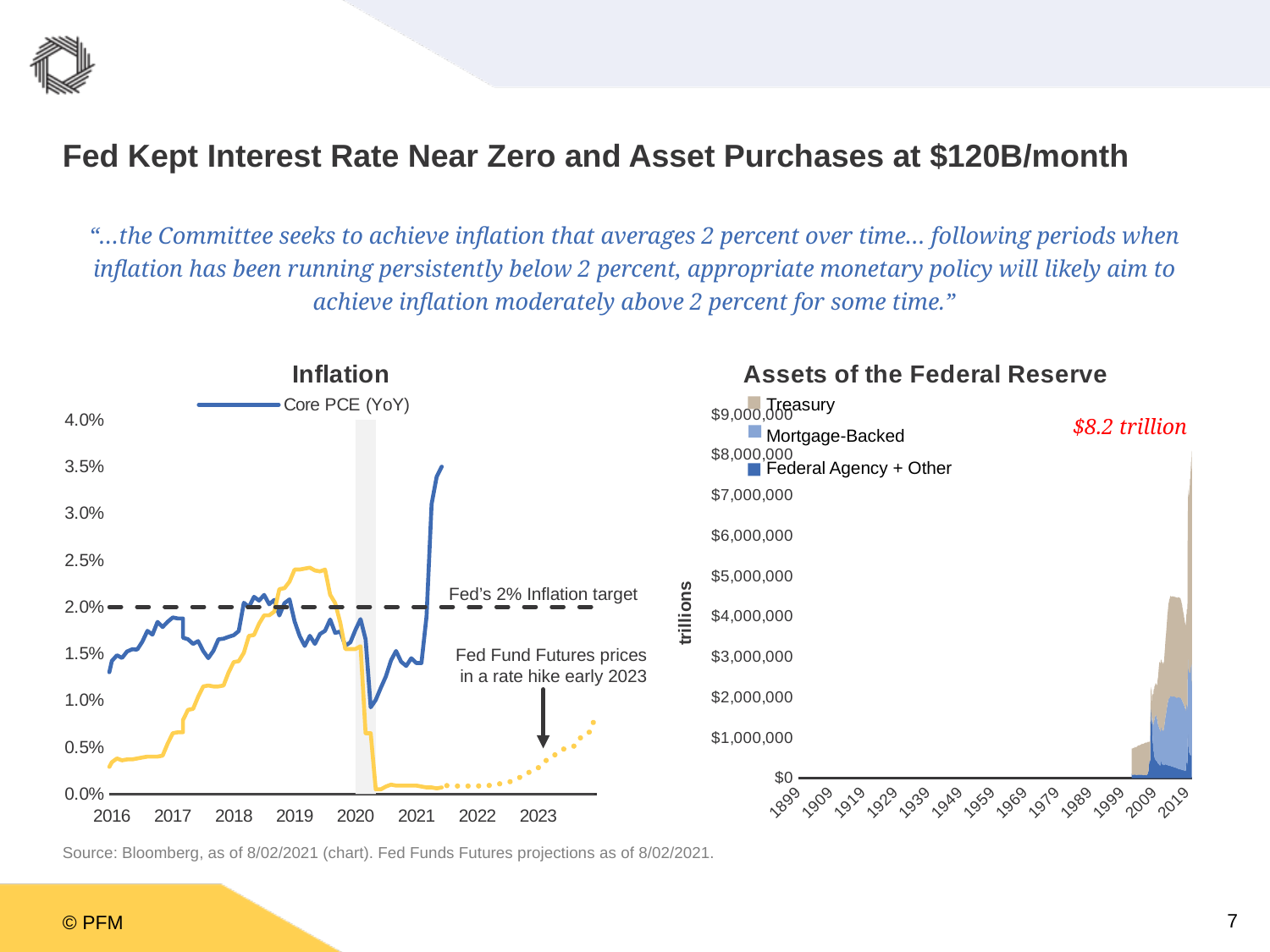
On the Inflation chart, is the highest value of Core PCE (YoY) greater or less than 3.0%? greater On the Inflation chart, what level is the Fed's inflation target shown by the dashed line? 2% What kind of chart is the Assets of the Federal Reserve chart? area chart On the Assets of the Federal Reserve chart, is the peak total value greater or less than $4,000,000? greater How many series does the legend of the Assets of the Federal Reserve chart list? 3 How many year labels are shown on the x axis of the Inflation chart? 8 What kind of chart is the Inflation chart? line chart What total value is annotated on the Assets of the Federal Reserve chart? $8.2 trillion On the Assets of the Federal Reserve chart, do total assets rise or fall from 1899 to 2019? rise How many series does the legend of the Inflation chart list? 1 On the Inflation chart, is the Core PCE (YoY) value at the start of 2016 greater or less than 2.0%? less On the Inflation chart, when do Fed Fund Futures price in a rate hike? early 2023